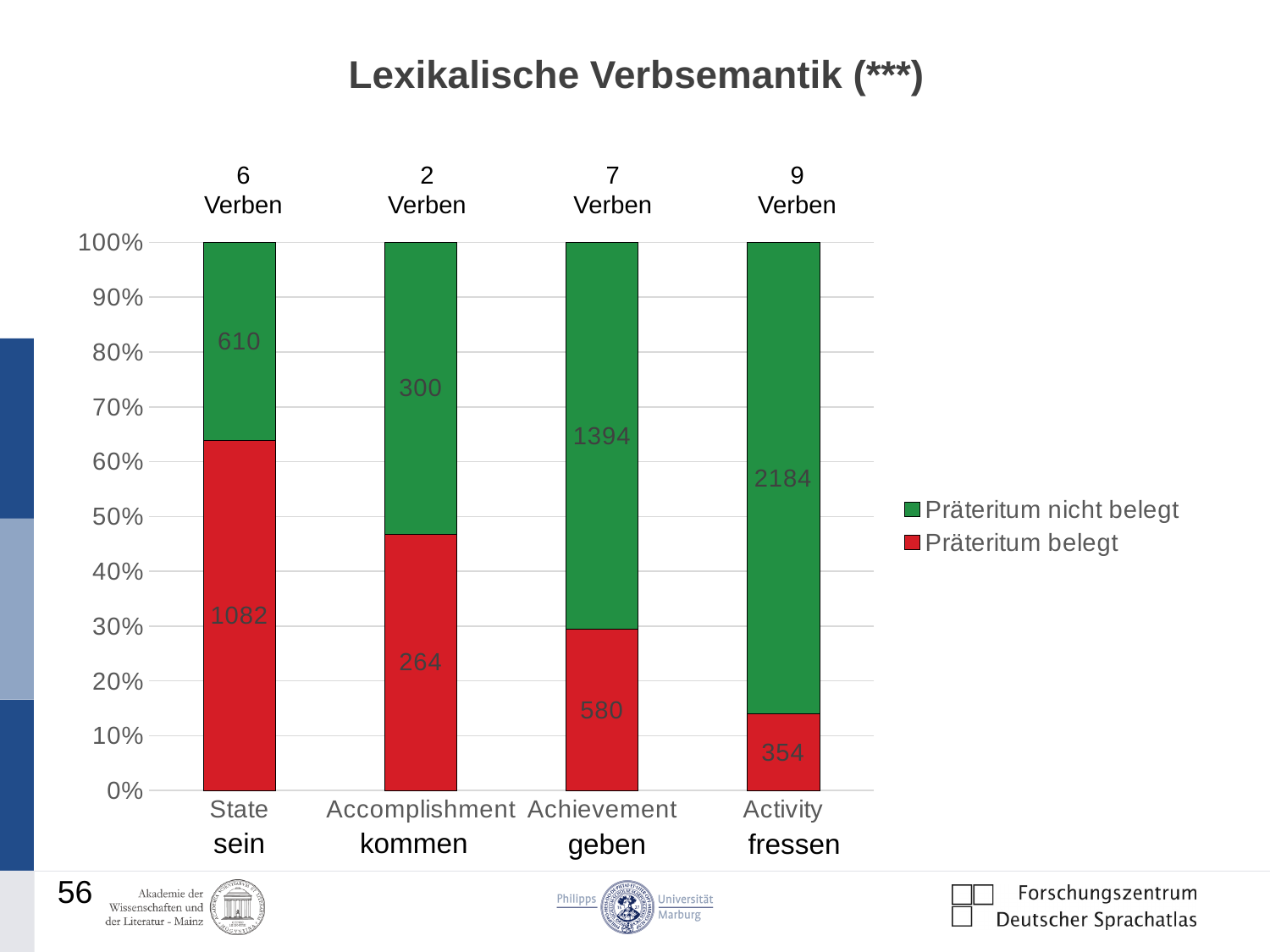
Which category has the lowest value for "Präteritum belegt"? Accomplishment What is the difference between the "Präteritum nicht belegt" values for Achievement and Accomplishment? 1094 What is the total of the two values in the Accomplishment bar? 564 How many series does the legend list? 2 Which category has the highest value for "Präteritum nicht belegt"? Activity What is the value of "Präteritum belegt" for Achievement? 580 Which is larger: the "Präteritum belegt" value for State or for Activity? State What is the value of "Präteritum belegt" for State? 1082 What kind of chart is shown on the slide? Stacked bar chart Is the "Präteritum belegt" share for Activity greater or less than 20%? less How many categories are shown on the x axis? 4 What is the value of "Präteritum nicht belegt" for Activity? 2184